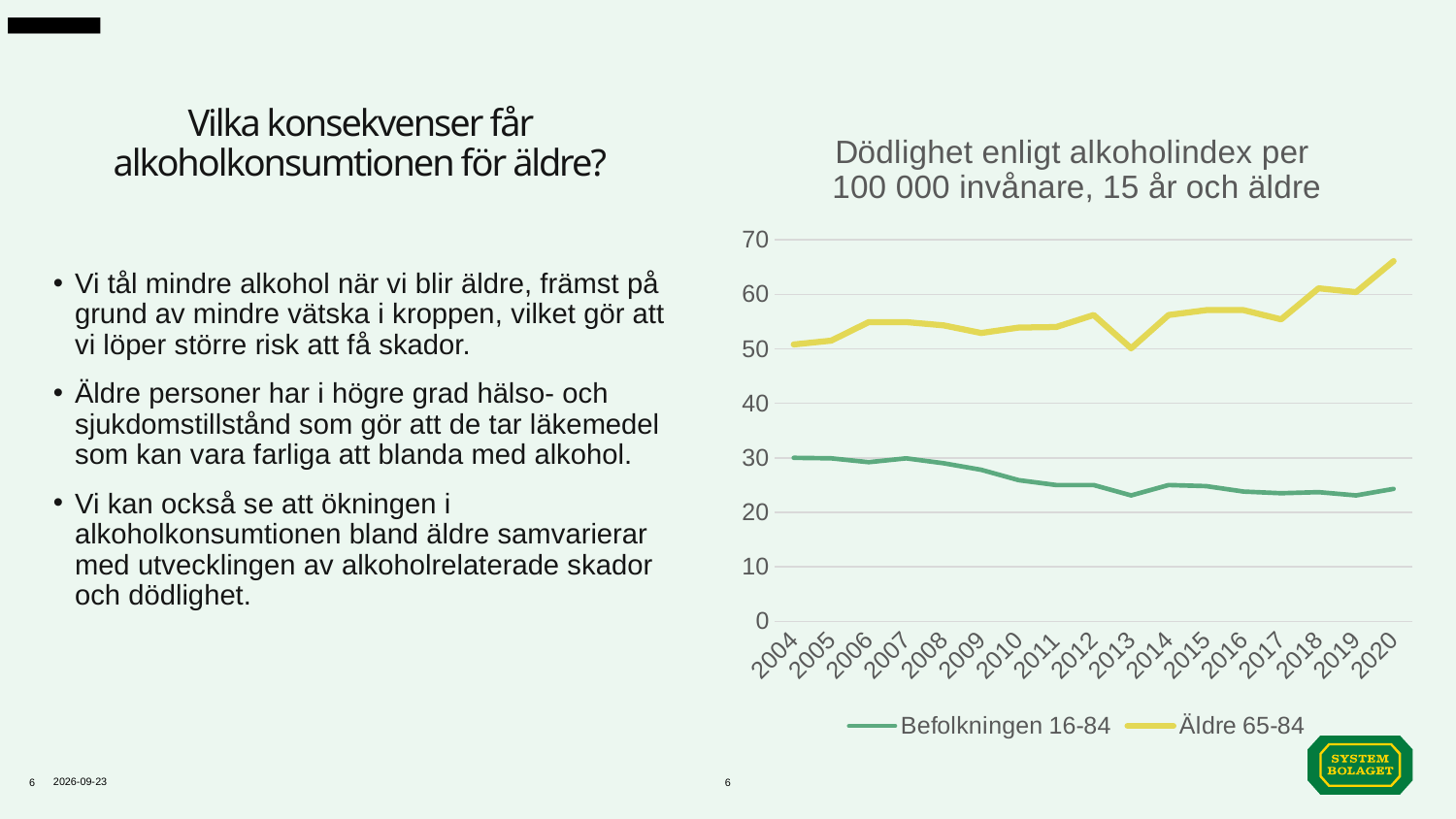
Does the value for Äldre 65-84 rise or fall overall from 2004 to 2020? Rise In which year is the value for Äldre 65-84 highest? 2020 What is the title of the chart? Dödlighet enligt alkoholindex per 100 000 invånare, 15 år och äldre Is the value for Äldre 65-84 in 2020 greater or less than 60? greater How many years are plotted along the x axis of the chart? 17 Is the value for Befolkningen 16-84 in 2020 greater or less than 30? less How many series does the legend of the chart list? 2 What kind of chart is shown on the slide? Line chart Which series is drawn in yellow in the chart? Äldre 65-84 Is the value for Äldre 65-84 in 2013 greater or less than 40? greater Does the value for Befolkningen 16-84 rise or fall overall from 2004 to 2020? Fall In 2020, which series has the larger value, Befolkningen 16-84 or Äldre 65-84? Äldre 65-84